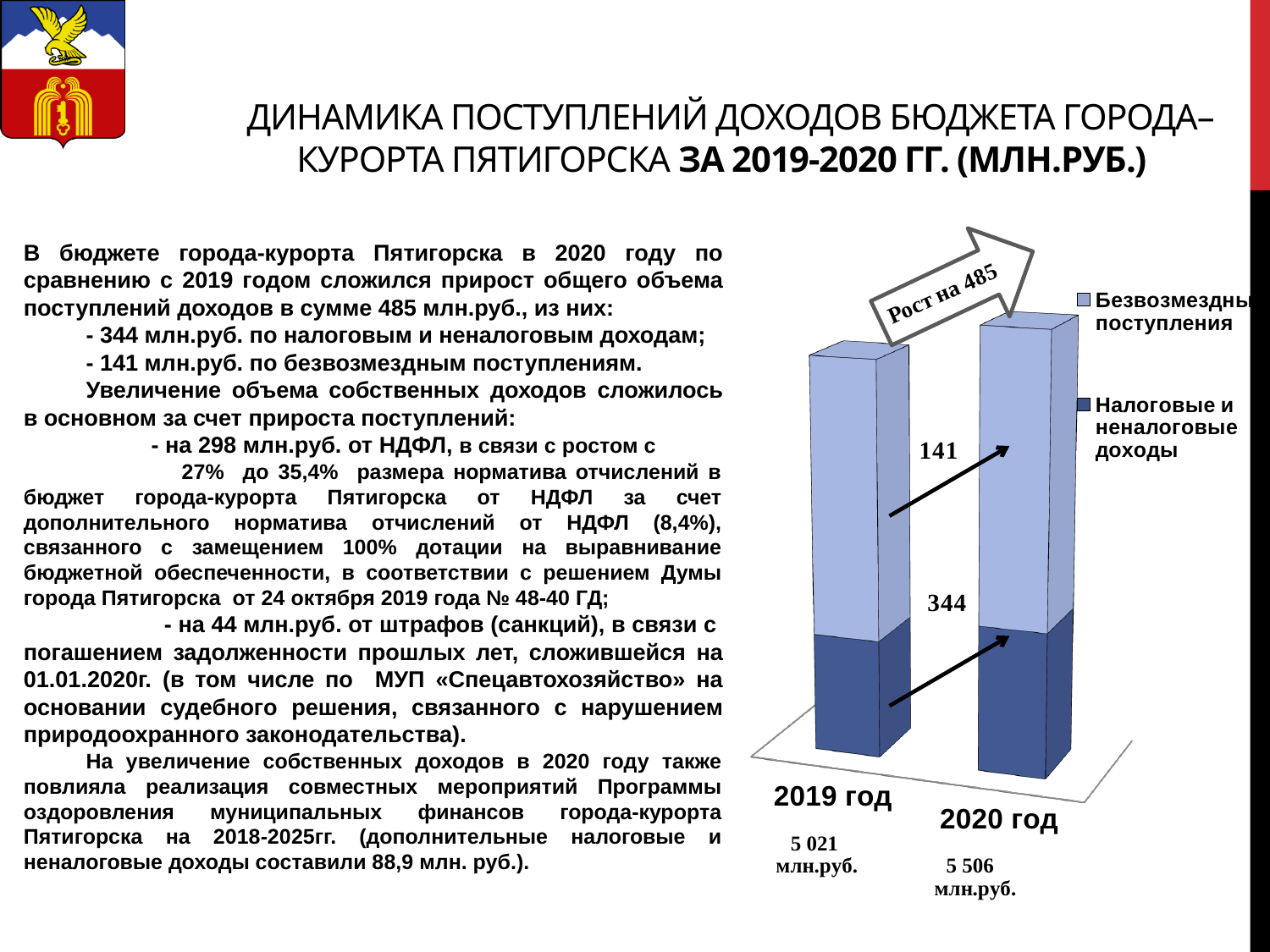
By how much did total revenue grow from 2019 год to 2020 год according to the chart? 485 Which year has the larger total revenue, 2019 год or 2020 год? 2020 год What text is written on the arrow above the bars? Рост на 485 How many series does the chart legend list? 2 What increase is labelled on the chart for Налоговые и неналоговые доходы between 2019 and 2020? 344 How many categories (years) are shown on the x axis of the chart? 2 What is the total budget revenue shown for 2019 год? 5 021 млн.руб. What is the total budget revenue shown for 2020 год? 5 506 млн.руб. What kind of chart is shown on the slide? Stacked bar chart What increase is labelled on the chart for Безвозмездные поступления between 2019 and 2020? 141 Which series is shown in dark blue in the chart legend? Налоговые и неналоговые доходы Do the total revenues rise or fall from 2019 год to 2020 год? Rise